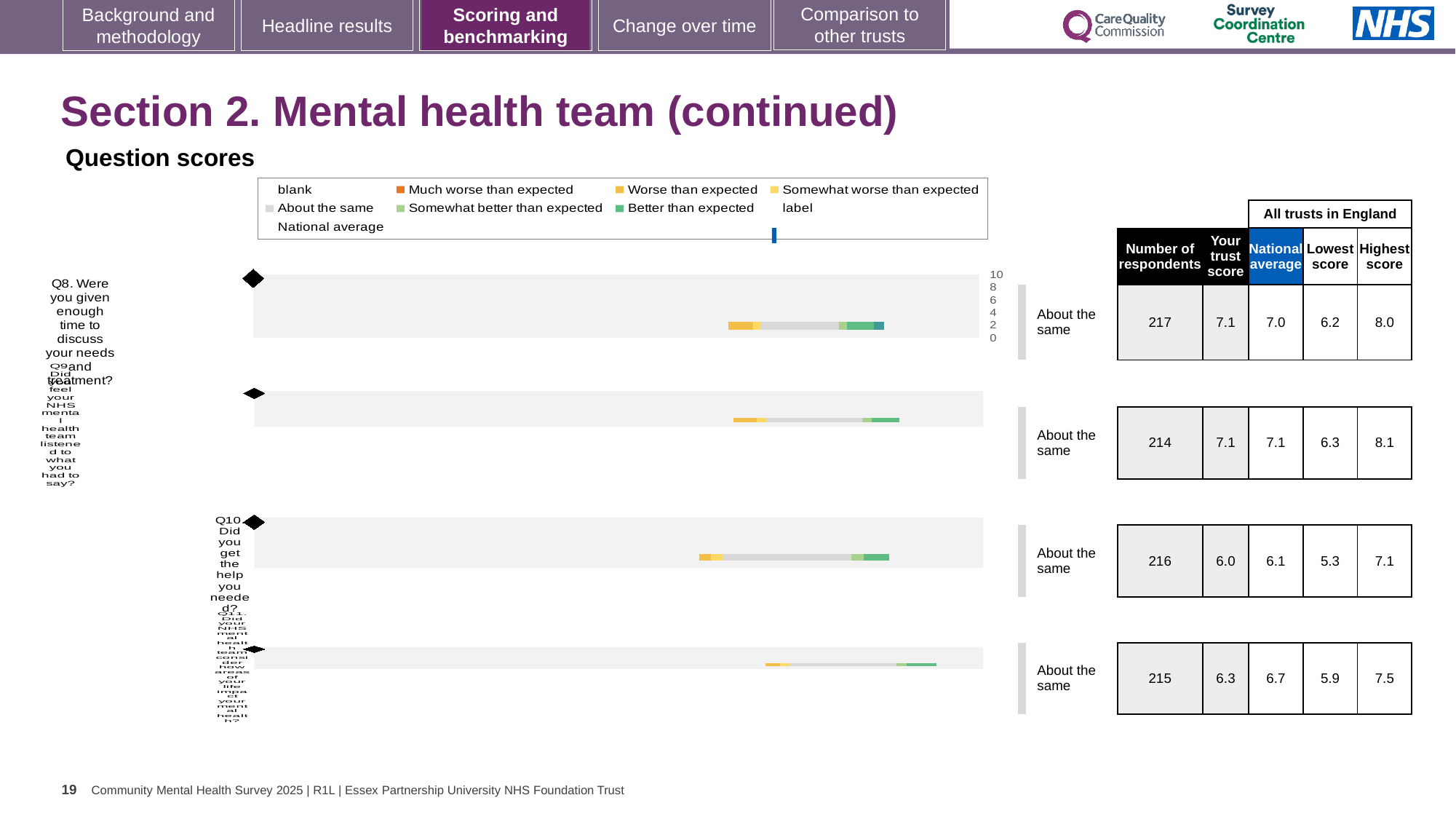
In the table next to the Q11 chart, what is the number of respondents? 215 How many question charts (Q8 to Q11) are shown on the slide? 4 In the table next to the Q10 chart, what is 'Your trust score'? 6.0 For Q11, which is larger: your trust score or the national average? National average In the table next to the Q8 chart, what is the number of respondents? 217 What colour does the legend use for 'Much worse than expected'? Orange For Q8, what is the difference between the highest score and the lowest score in the table? 1.8 In the table next to the Q11 chart, what is the national average? 6.7 What kind of chart is used to show the question scores on this slide? bar chart What benchmark category is shown beside each of the four question charts? About the same Which question has the highest 'Highest score' in the table? Q9 (8.1) Which question has the lowest 'Lowest score' in the table? Q10 (5.3)